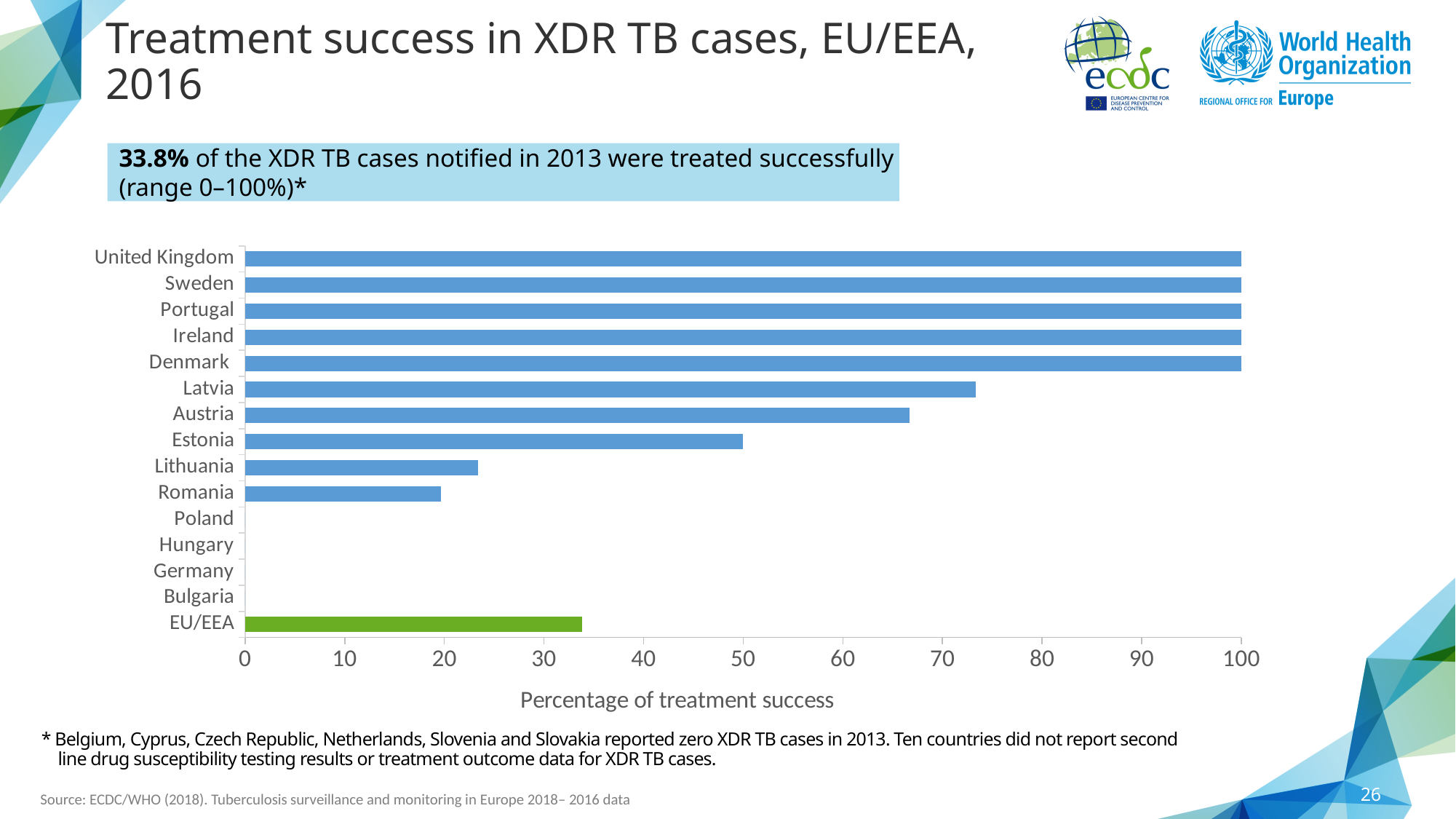
Is the value for Lithuania greater or less than 20? greater Is the value for Latvia greater or less than 70? greater Is the value for Romania greater or less than 30? less How many categories are listed on the vertical axis of the chart? 15 What kind of chart is shown on the slide? bar chart What is the percentage of treatment success for EU/EEA? 33.8% What is the title of the horizontal axis of the chart? Percentage of treatment success Which has a higher percentage of treatment success, Latvia or Austria? Latvia What is the percentage of treatment success for the United Kingdom? 100 What is the percentage of treatment success for Estonia? 50 Which has a higher percentage of treatment success, Estonia or Lithuania? Estonia